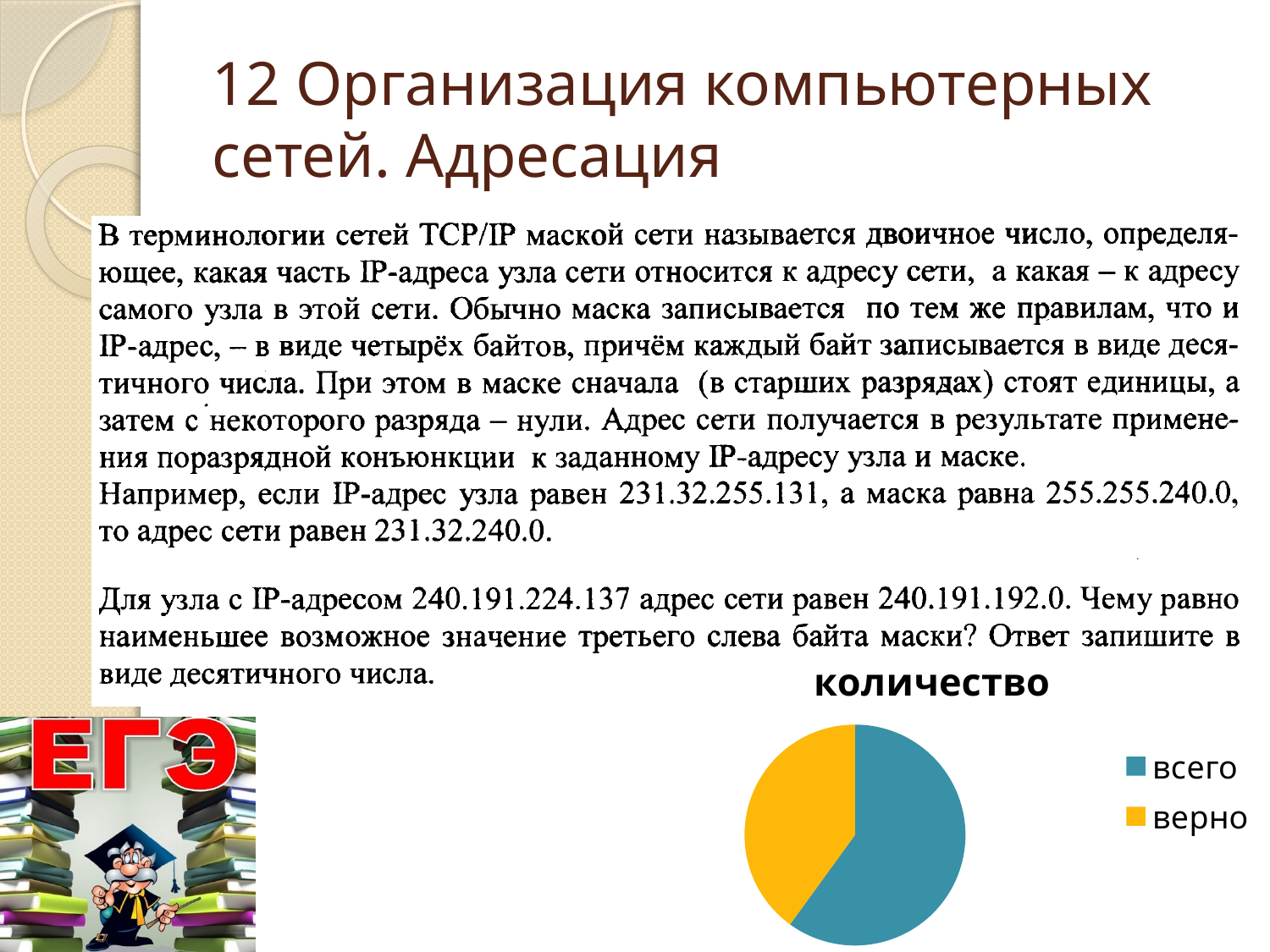
What is the title of the pie chart? количество How many slices does the pie chart have? 2 In the pie chart, which slice is larger: всего or верно? всего Which slice of the pie chart is the largest? всего How many entries does the legend of the pie chart list? 2 What kind of chart is shown on the slide? pie chart Which slice of the pie chart is the smallest? верно What colour is the slice for верно in the pie chart? yellow